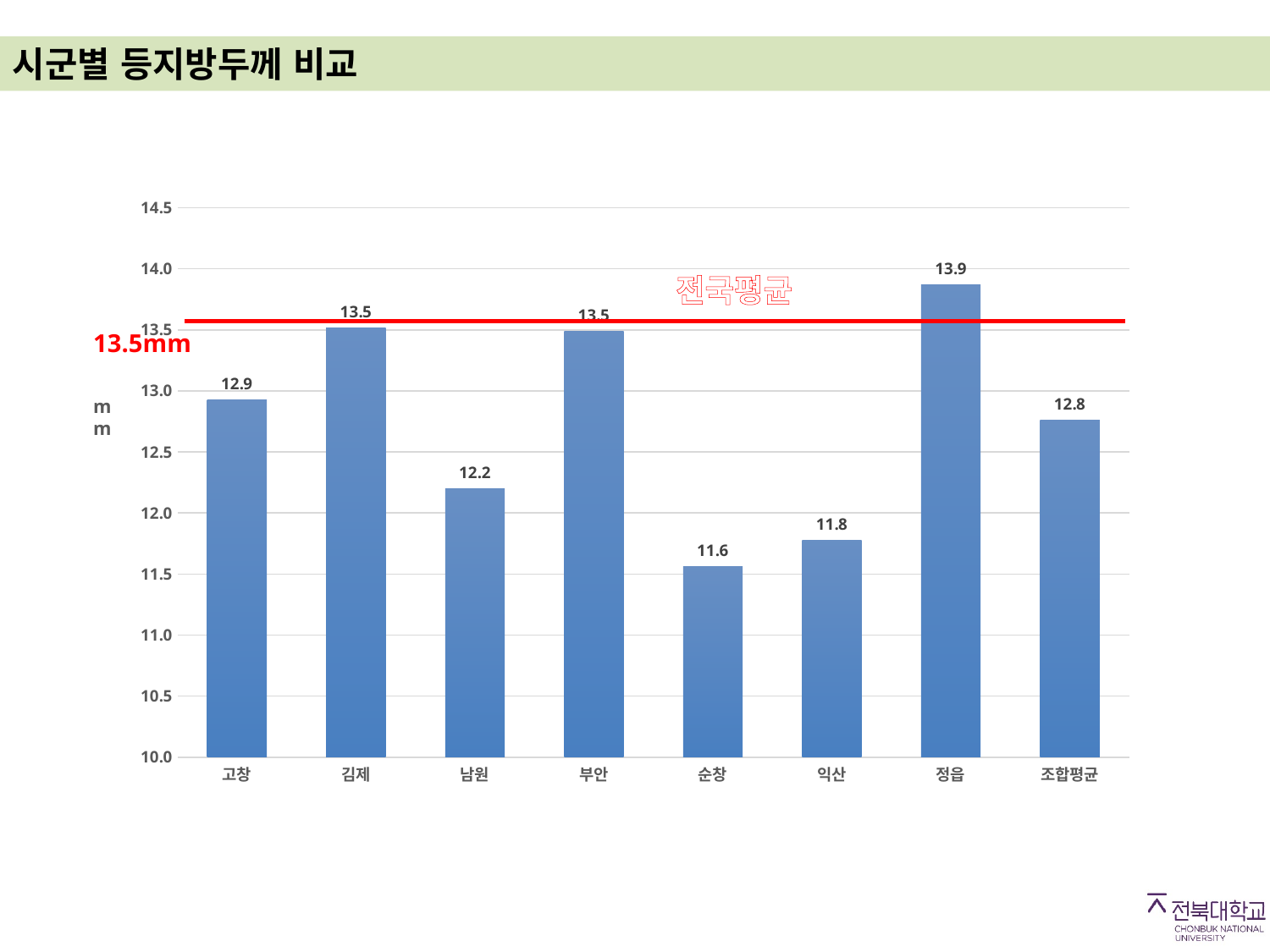
What kind of chart is shown on the slide? bar chart What is the difference between the values for 정읍 and 순창? 2.3 What is the value for 순창? 11.6 How many categories are shown on the x axis? 8 Is the value for 익산 greater or less than 12.0? less What is the value for 정읍? 13.9 Which category has the highest value? 정읍 What value does the red horizontal line labelled 전국평균 mark? 13.5mm Which category has the lowest value? 순창 What is the value for 고창? 12.9 What is the value for 조합평균? 12.8 Which is larger, the value for 남원 or the value for 익산? 남원